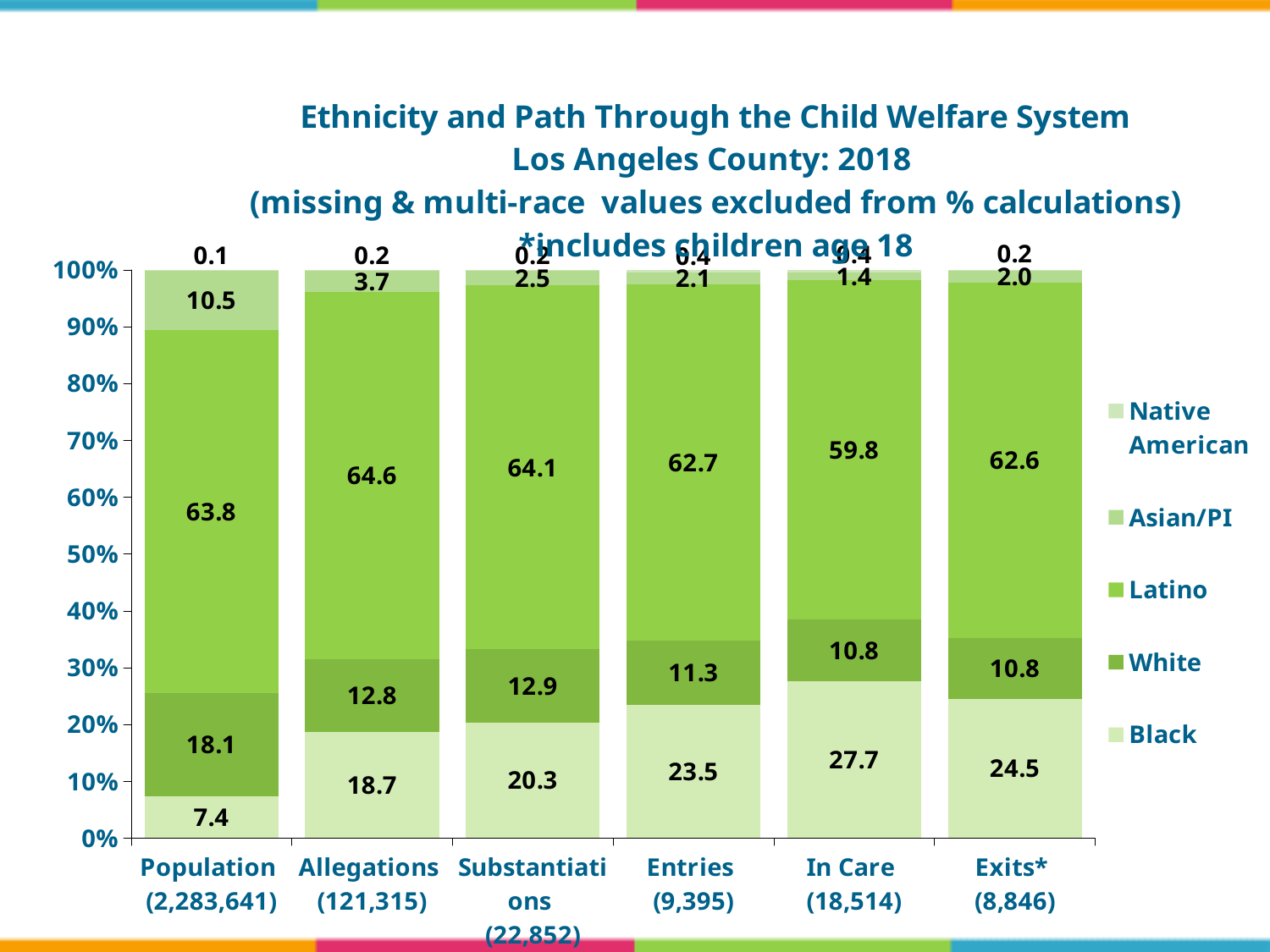
What kind of chart is this? Stacked bar chart Which category has the lowest Latino value? In Care What is the Latino value for the In Care bar? 59.8 Which category has the highest Black value? In Care What is the Black value for the Population bar? 7.4 Do the Black values rise or fall from Population to In Care? Rise What is the Asian/PI value for the Population bar? 10.5 What number is shown in parentheses under the Allegations category label? 121,315 How many series does the legend list? 5 Which is larger, the Black value for Entries or the Black value for Exits*? Exits* What is the difference between the White value for Population and the White value for Allegations? 5.3 How many categories are shown on the x axis? 6